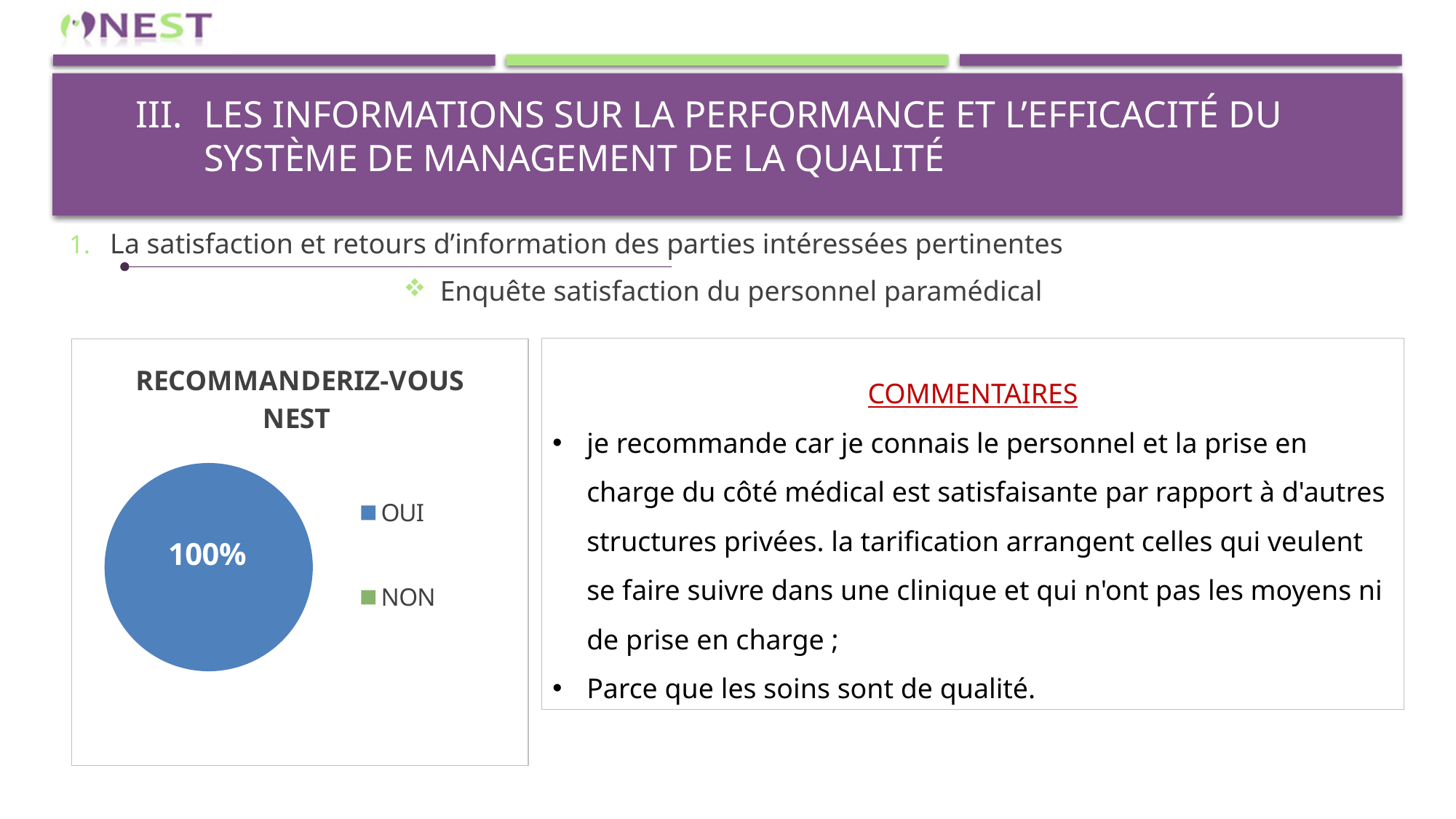
How many entries does the legend of the pie chart list? 2 Which category has the smallest share in the pie chart? NON What kind of chart is shown under the title "RECOMMANDERIZ-VOUS NEST"? pie chart What percentage label is printed on the pie chart? 100% Which category has the largest share in the pie chart? OUI Which is larger in the pie chart, OUI or NON? OUI What colour is the OUI entry in the pie chart legend? blue What is the title of the pie chart? RECOMMANDERIZ-VOUS NEST What share of the pie chart does the OUI slice represent? 100%